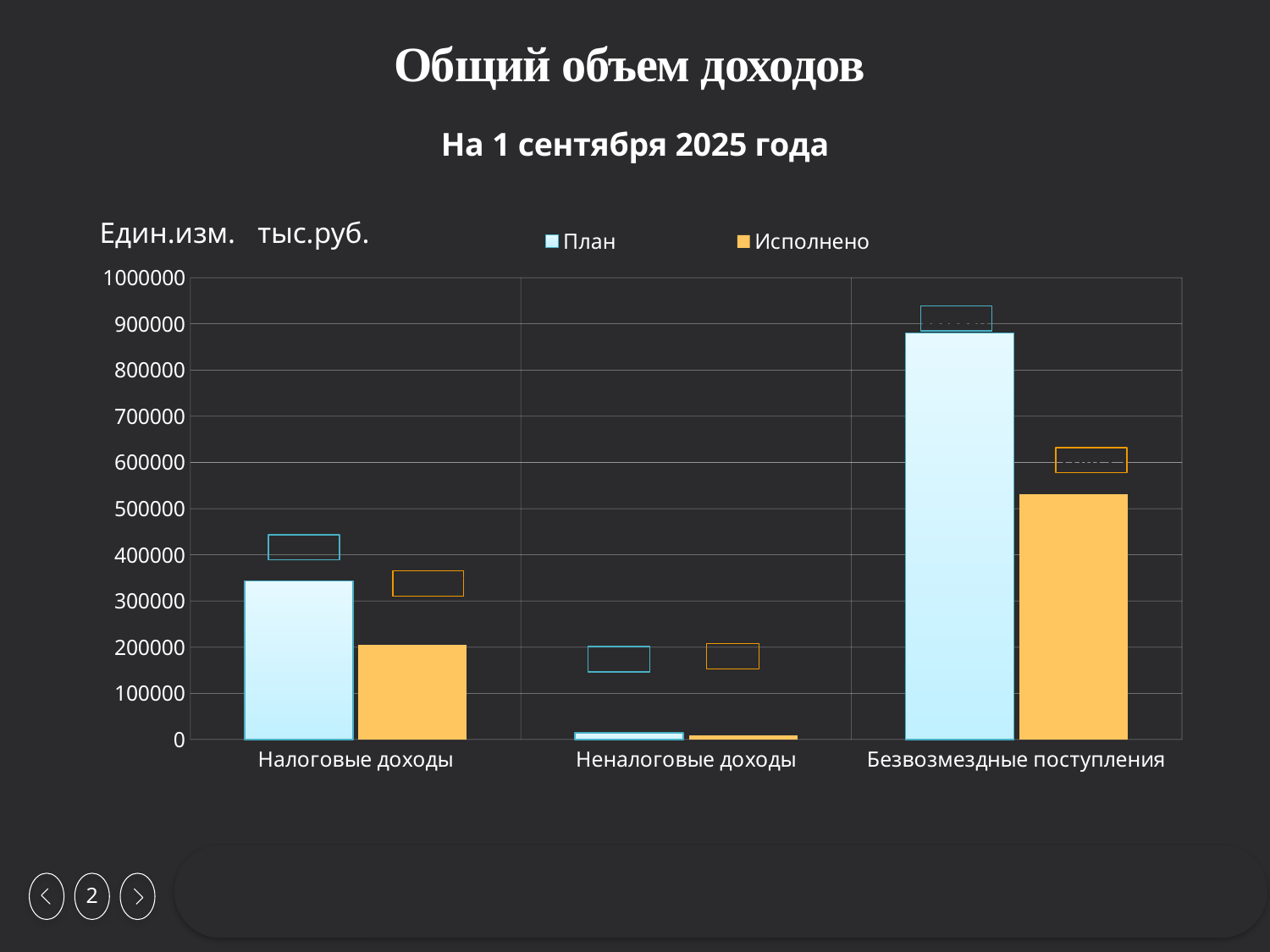
For Безвозмездные поступления, which is larger: План or Исполнено? План How many categories are shown on the x axis? 3 Is the План value for Неналоговые доходы greater or less than 100000? less What unit of measurement is stated on the slide for the chart values? тыс.руб. Which category has the highest План value? Безвозмездные поступления How many series does the legend list? 2 What kind of chart is shown on the slide? bar chart Is the План value for Безвозмездные поступления greater or less than 800000? greater Is the Исполнено value for Безвозмездные поступления greater or less than 600000? less Which category has the lowest Исполнено value? Неналоговые доходы